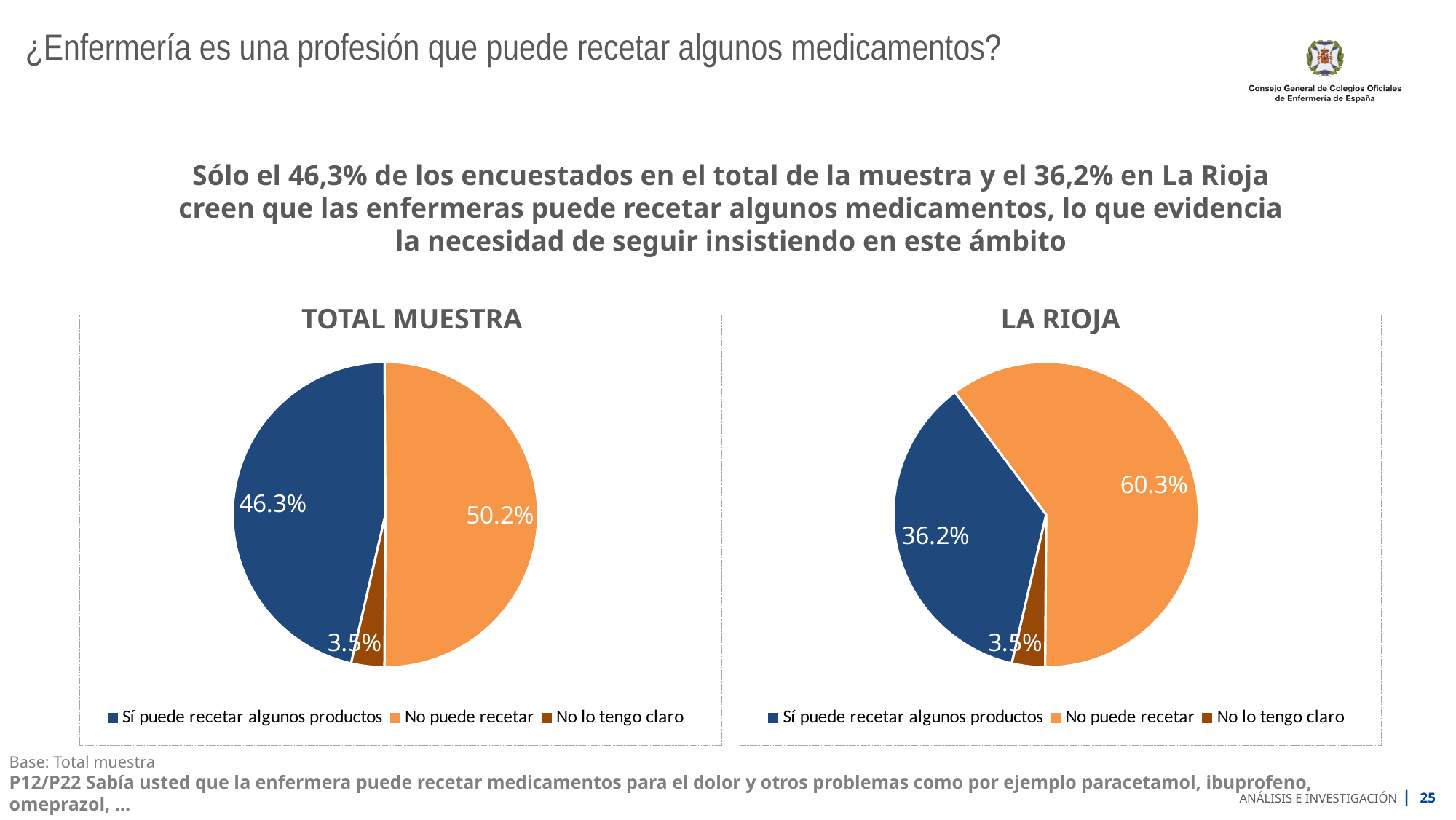
In the LA RIOJA chart, which category has the smallest slice? No lo tengo claro In the LA RIOJA chart, what share is labelled for 'Sí puede recetar algunos productos'? 36.2% In the LA RIOJA chart, what share is labelled for 'No lo tengo claro'? 3.5% What kind of chart is the TOTAL MUESTRA chart? Pie chart In the TOTAL MUESTRA chart, what share is labelled for 'No puede recetar'? 50.2% What is the difference between the 'No puede recetar' share in the LA RIOJA chart and in the TOTAL MUESTRA chart? 10.1% In the TOTAL MUESTRA chart, which category has the largest slice? No puede recetar How many slices does the LA RIOJA chart have? 3 Which is larger: the 'Sí puede recetar algunos productos' share in the TOTAL MUESTRA chart or in the LA RIOJA chart? TOTAL MUESTRA In the TOTAL MUESTRA chart, what colour is the 'No lo tengo claro' slice? Dark brown In the LA RIOJA chart, what share is labelled for 'No puede recetar'? 60.3% In the TOTAL MUESTRA chart, what share is labelled for 'Sí puede recetar algunos productos'? 46.3%